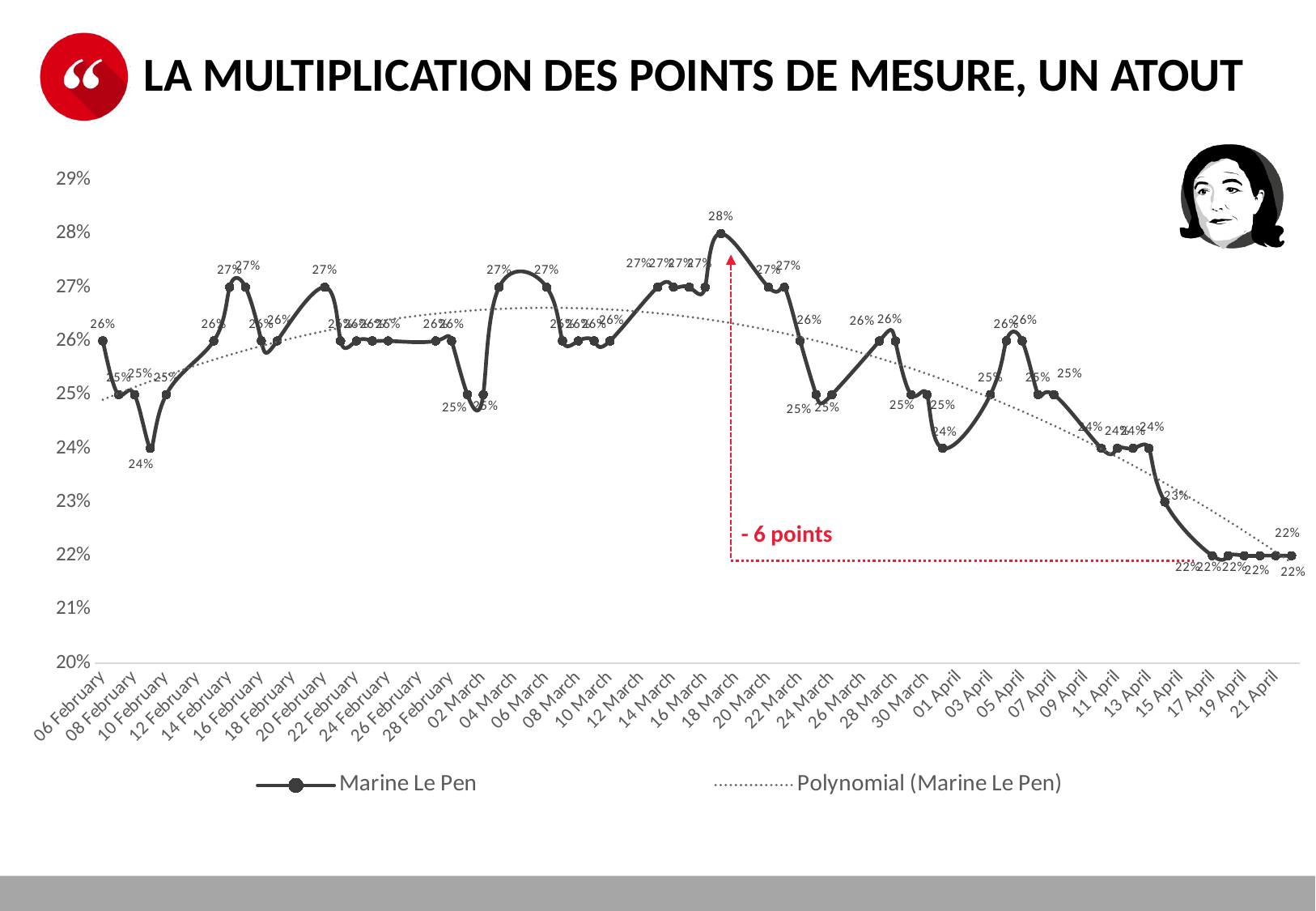
What is the value for Marine Le Pen on 21 April? 22% What kind of chart is shown on the slide? line chart What is the lowest value reached by the Marine Le Pen line? 22% What does the red annotation on the chart say? - 6 points Overall, does the Marine Le Pen line rise or fall from February to April? fall How many series does the legend list? 2 What is the value for Marine Le Pen on 06 February? 26% Which is larger, the value on 18 March or the value on 21 April? 18 March What is the name of the dotted series in the legend? Polynomial (Marine Le Pen) What is the highest value reached by the Marine Le Pen line? 28% What is the difference between the peak value of 28% and the final value of 22%? 6 points What is the value for Marine Le Pen on 10 February? 25%